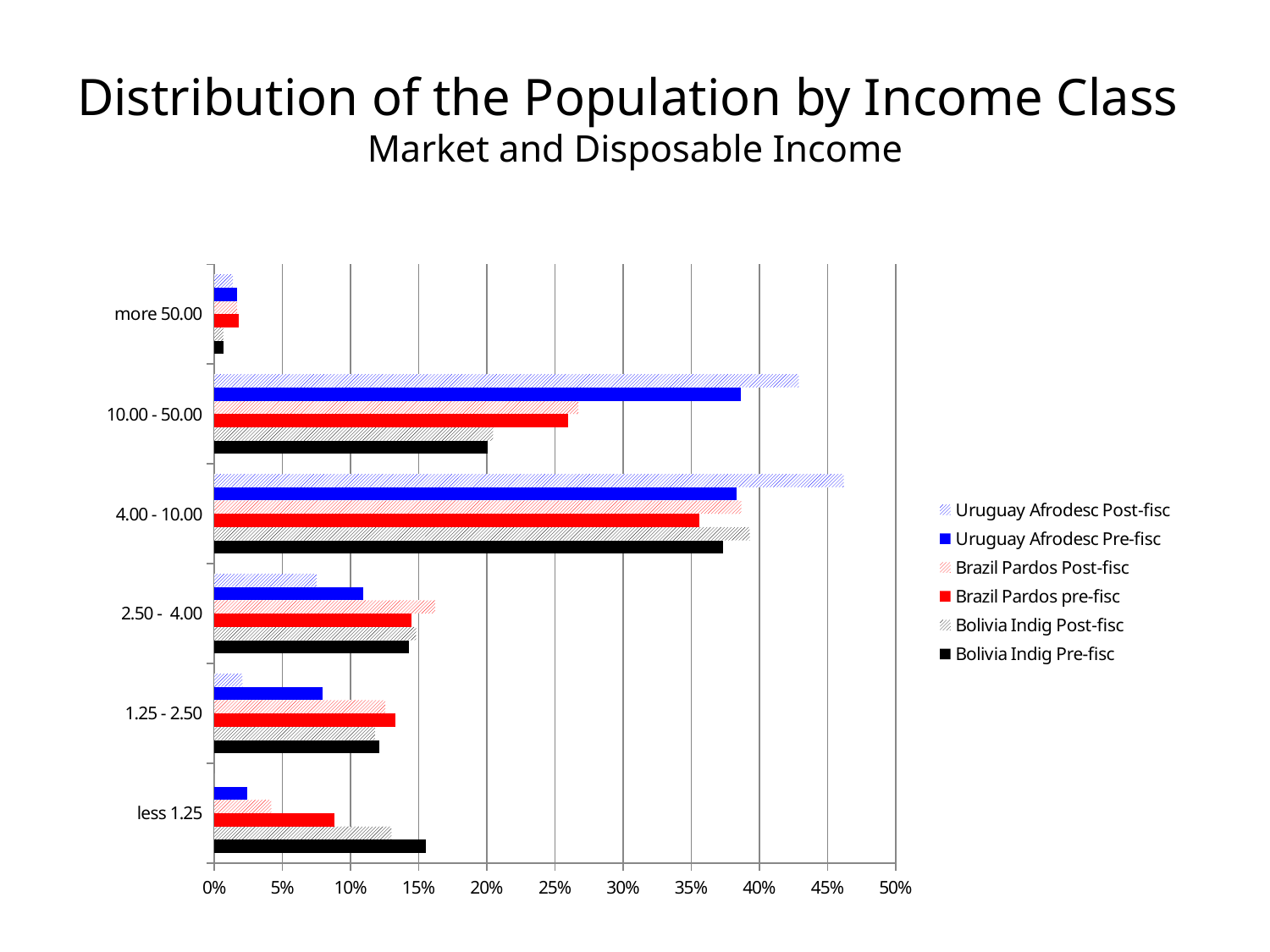
What colour are the bars for Bolivia Indig Pre-fisc? black Is the value for Uruguay Afrodesc Post-fisc in the 4.00 - 10.00 income class greater or less than 40%? greater Which series has the highest value in the 10.00 - 50.00 income class? Uruguay Afrodesc Post-fisc In the 2.50 - 4.00 income class, which is larger: Brazil Pardos Post-fisc or Uruguay Afrodesc Post-fisc? Brazil Pardos Post-fisc Which income class has the highest value for Uruguay Afrodesc Post-fisc? 4.00 - 10.00 Is the value for Bolivia Indig Pre-fisc in the less 1.25 income class greater or less than 10%? greater What kind of chart is shown on the slide? bar chart Is the value for Brazil Pardos pre-fisc in the 10.00 - 50.00 income class greater or less than 30%? less In the less 1.25 income class, which is larger: Bolivia Indig Pre-fisc or Uruguay Afrodesc Pre-fisc? Bolivia Indig Pre-fisc Which income class has the lowest value for Bolivia Indig Pre-fisc? more 50.00 How many income classes are shown on the chart? 6 How many series does the legend list? 6